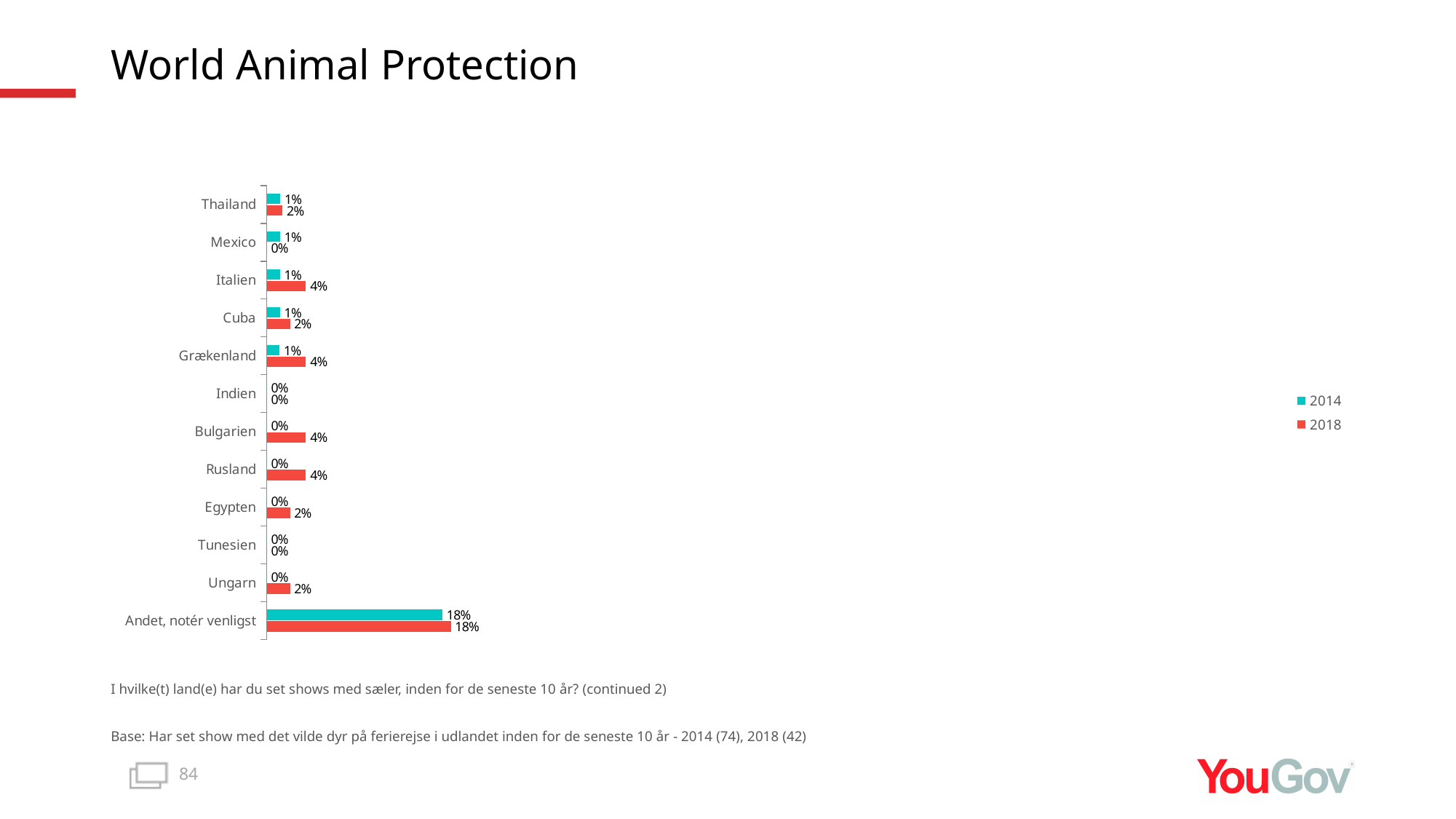
Which is larger for Mexico, the 2014 value or the 2018 value? 2014 Which series is shown in red in the legend? 2018 What is the 2014 value for Thailand? 1% How many series does the legend list? 2 What kind of chart is shown on the slide? Bar chart Which category has the highest 2018 value? Andet, notér venligst What is the 2018 value for Egypten? 2% What is the 2018 value for Italien? 4% What is the difference between the 2018 and 2014 values for Grækenland? 3% What is the 2018 value for Bulgarien? 4% What is the difference between the 2018 values for Rusland and Ungarn? 2% How many categories are shown on the chart? 12